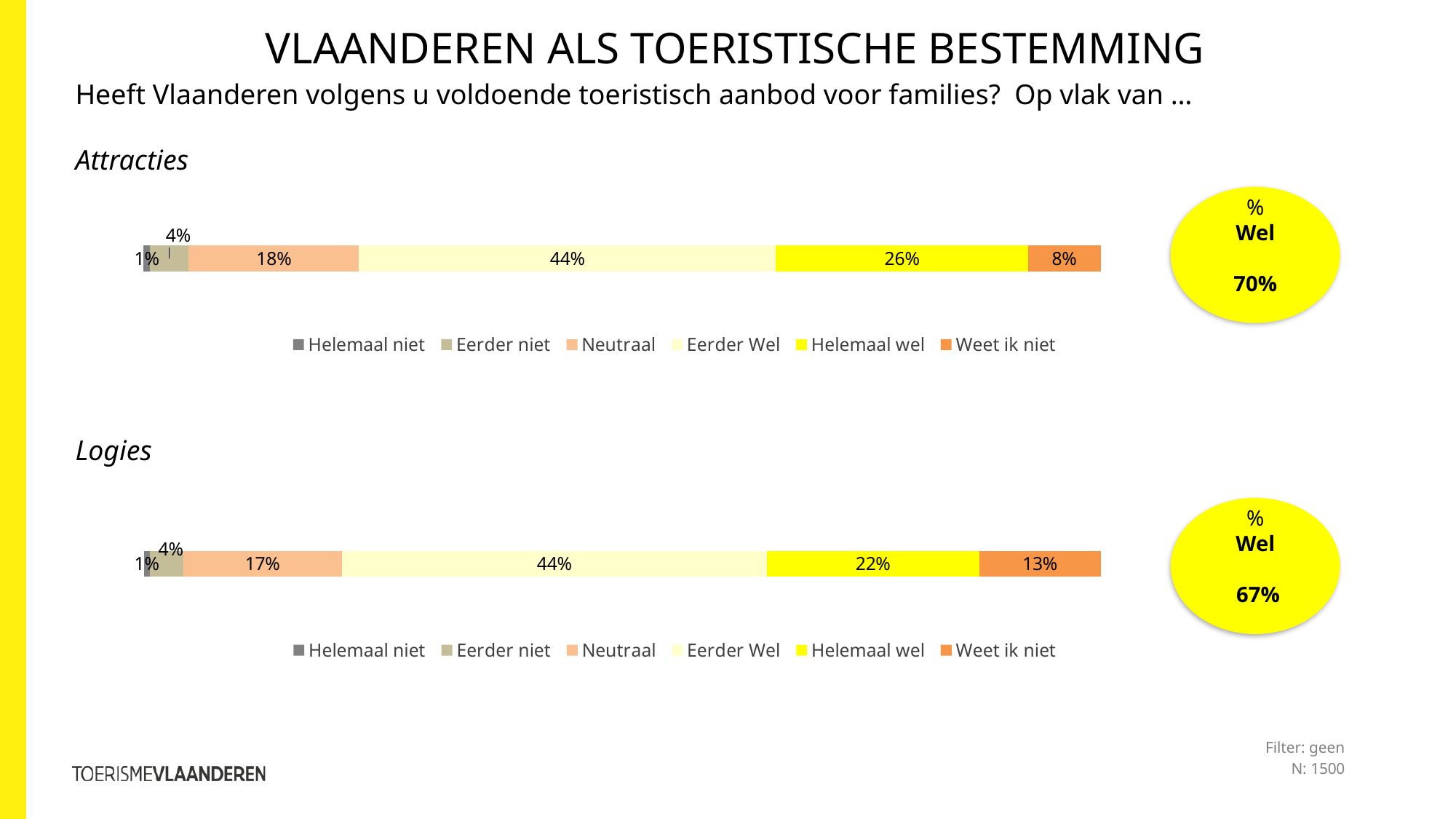
In the Logies chart, what is the value for Neutraal? 17% In the Attracties chart, what colour is the Helemaal wel segment? Yellow What is the '% Wel' value shown next to the Logies chart? 67% What kind of chart is the Attracties chart? Bar chart How many series does the legend of the Logies chart list? 6 In the Attracties chart, which category has the highest value? Eerder Wel In the Logies chart, what is the value for Weet ik niet? 13% In the Attracties chart, what is the value for Helemaal wel? 26% In the Attracties chart, what is the difference between Helemaal wel and Weet ik niet? 18% In the Attracties chart, what is the value for Eerder Wel? 44% Which is larger: Helemaal wel in the Attracties chart or Helemaal wel in the Logies chart? Attracties In the Logies chart, which category has the lowest value? Helemaal niet